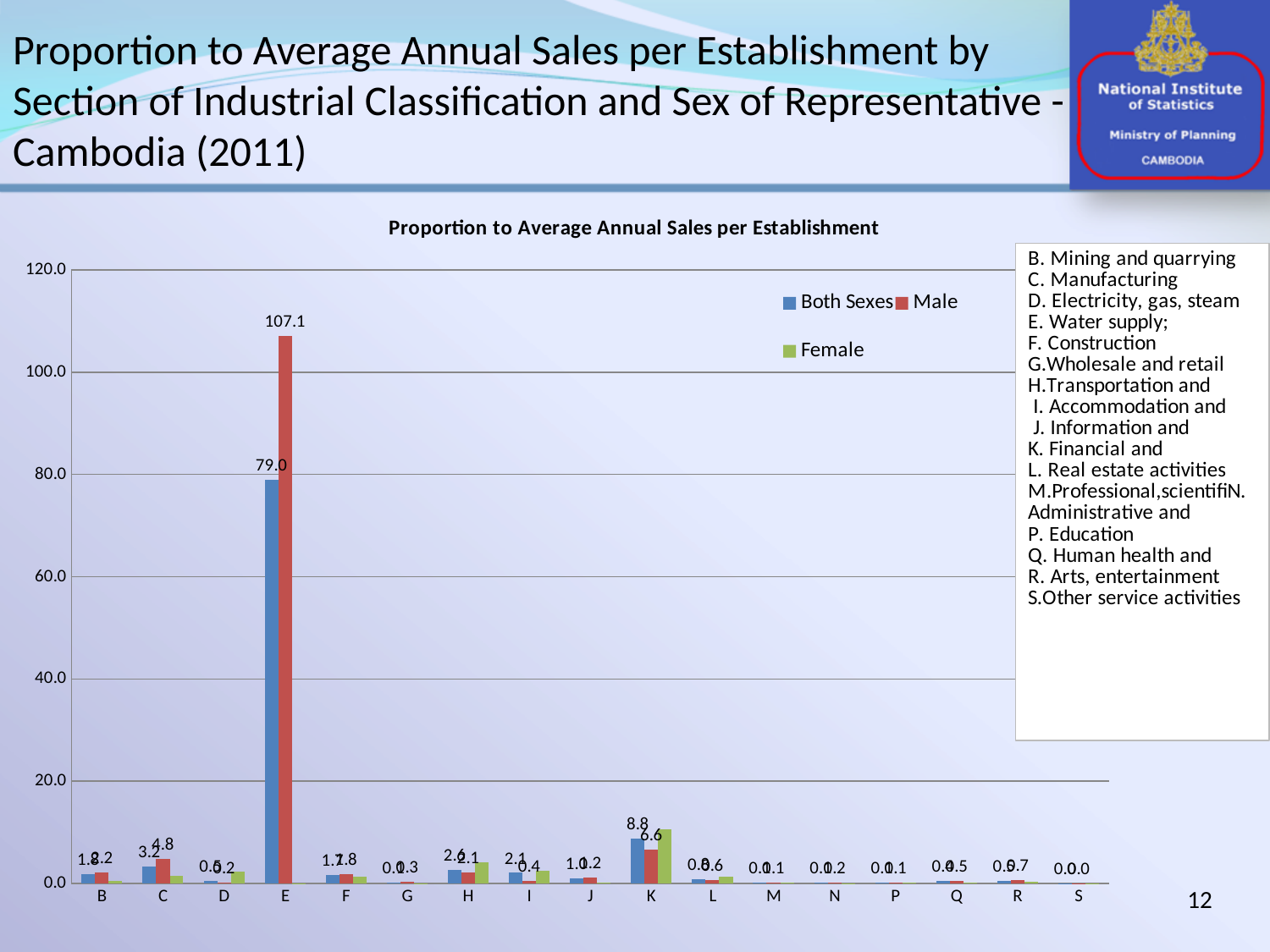
Which category has the highest Both Sexes value? E What is the Male value for category E? 107.1 For category E, which is larger: the Male value or the Both Sexes value? Male What is the Both Sexes value for category E? 79.0 What are the three series listed in the chart legend? Both Sexes, Male, Female What kind of chart is shown on the slide? bar chart How many series does the chart legend list? 3 How many categories are shown along the x axis of the chart? 17 Is the Male value for category E greater or less than 100? greater Which category has the highest Male value? E What is the Both Sexes value for category K? 8.8 What is the difference between the Male and Both Sexes values for category E? 28.1